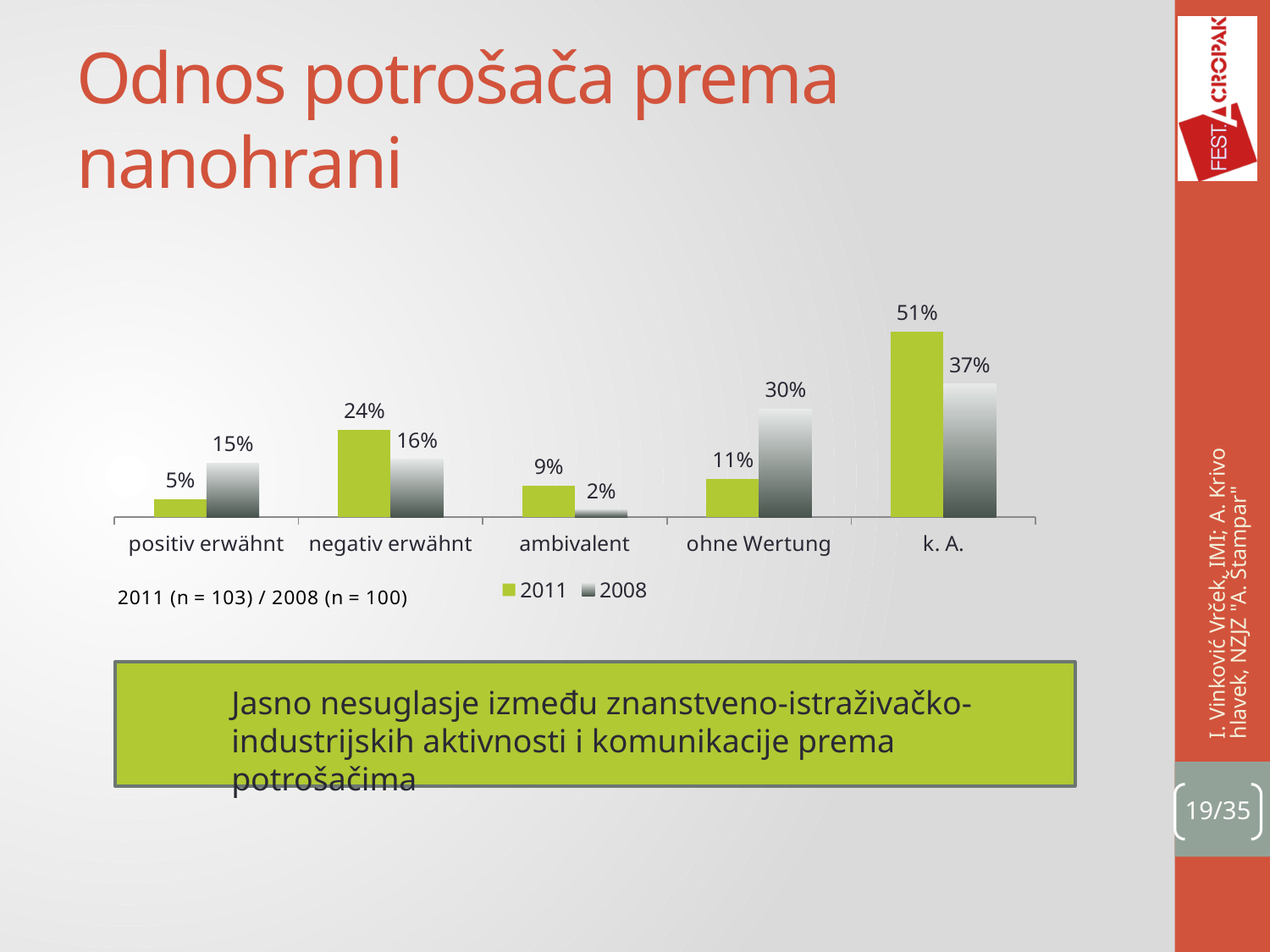
What is the 2011 value for "negativ erwähnt"? 24% What are the two series listed in the legend? 2011 and 2008 Which category has the highest 2011 value? k. A. Which category has the lowest 2008 value? ambivalent What is the 2008 value for "ambivalent"? 2% What kind of chart is shown on the slide? bar chart How many categories are shown on the x axis? 5 Which is larger for "positiv erwähnt": the 2011 value or the 2008 value? 2008 What is the difference between the 2011 and 2008 values for "ohne Wertung"? 19% How many series does the legend list? 2 What is the difference between the 2011 and 2008 values for "k. A."? 14% What is the 2008 value for "ohne Wertung"? 30%